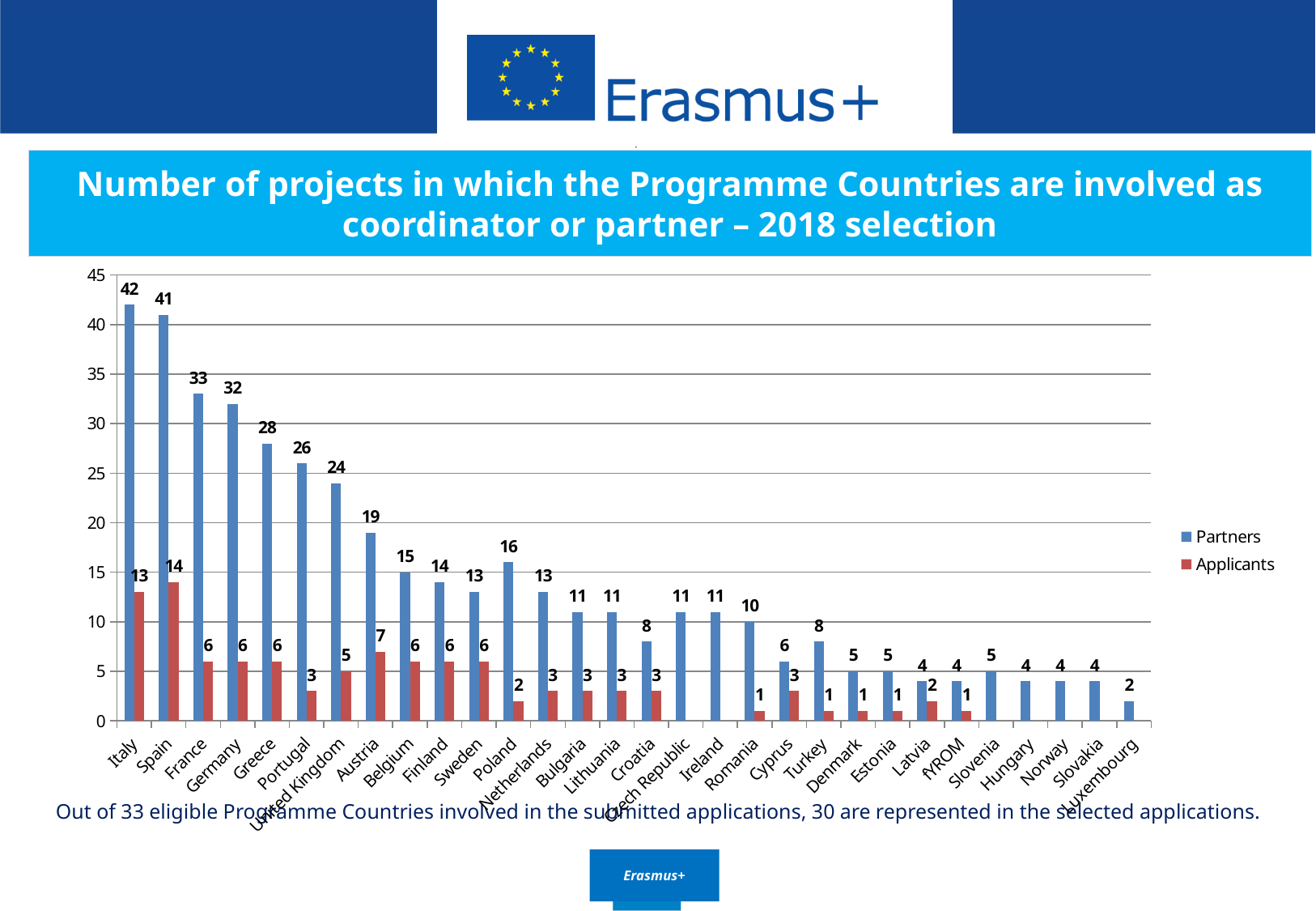
What kind of chart is shown on the slide? Bar chart What is the difference between the Partners and Applicants values for Italy? 29 What is the difference between the Partners values for France and Germany? 1 Which country has the highest Partners value? Italy Which is larger, the Partners value for Poland or the Partners value for Belgium? Poland Which country has the highest Applicants value? Spain Which country has the lowest Partners value? Luxembourg What is the Applicants value for Spain? 14 What is the Partners value for Italy? 42 How many series does the legend list? 2 What is the Partners value for the United Kingdom? 24 What is the Applicants value for Austria? 7